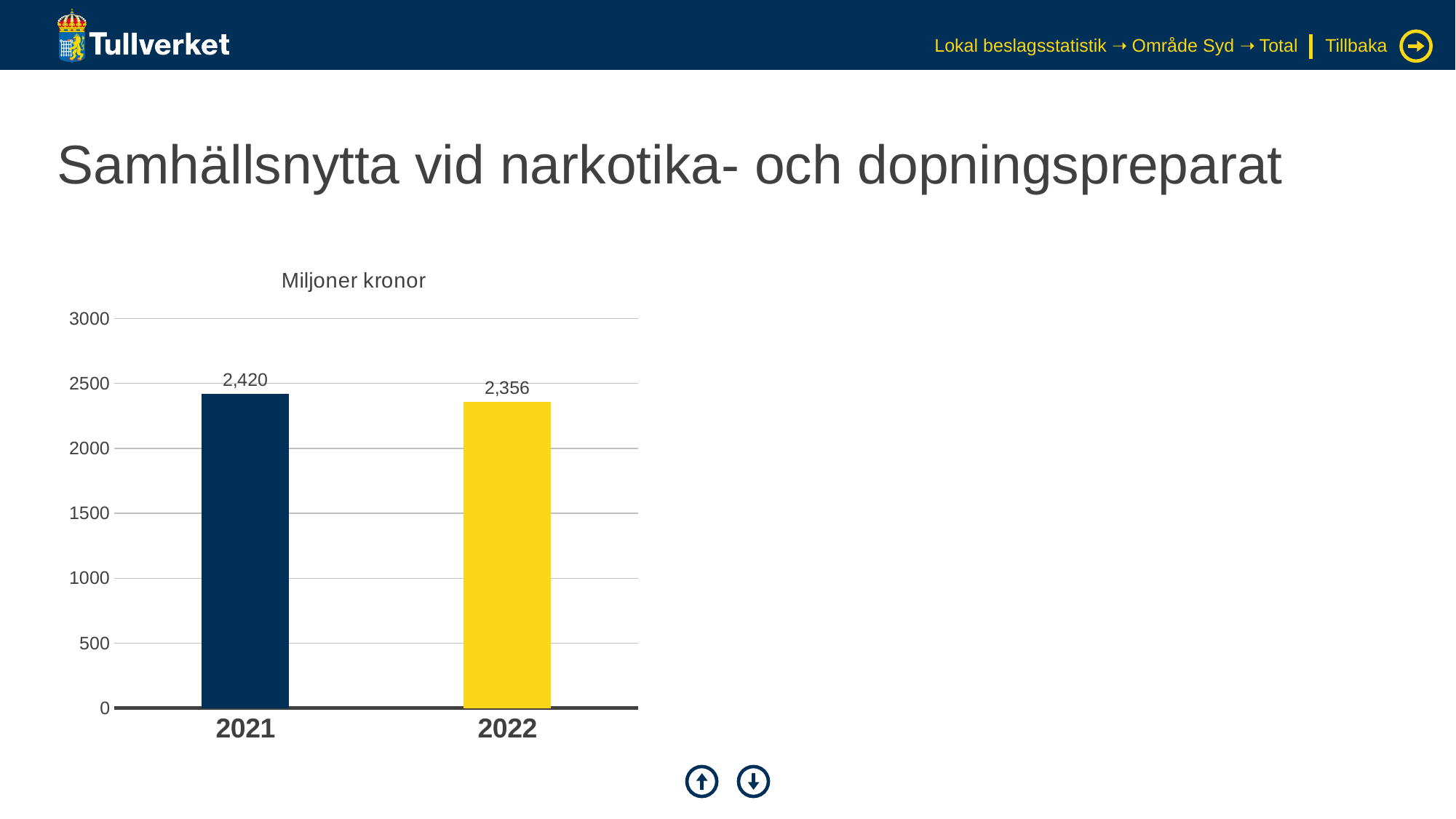
Which is larger, the value for 2021 or the value for 2022? 2021 What kind of chart is shown on the slide? bar chart What is the value for 2021? 2,420 Is the value for 2021 greater or less than 2000? greater What unit is shown above the chart? Miljoner kronor Which year has the lowest value? 2022 What is the value for 2022? 2,356 Is the value for 2022 greater or less than 2500? less Which year has the highest value? 2021 How many years are shown on the x axis? 2 What is the difference between the values for 2021 and 2022? 64 Do the values rise or fall from 2021 to 2022? fall